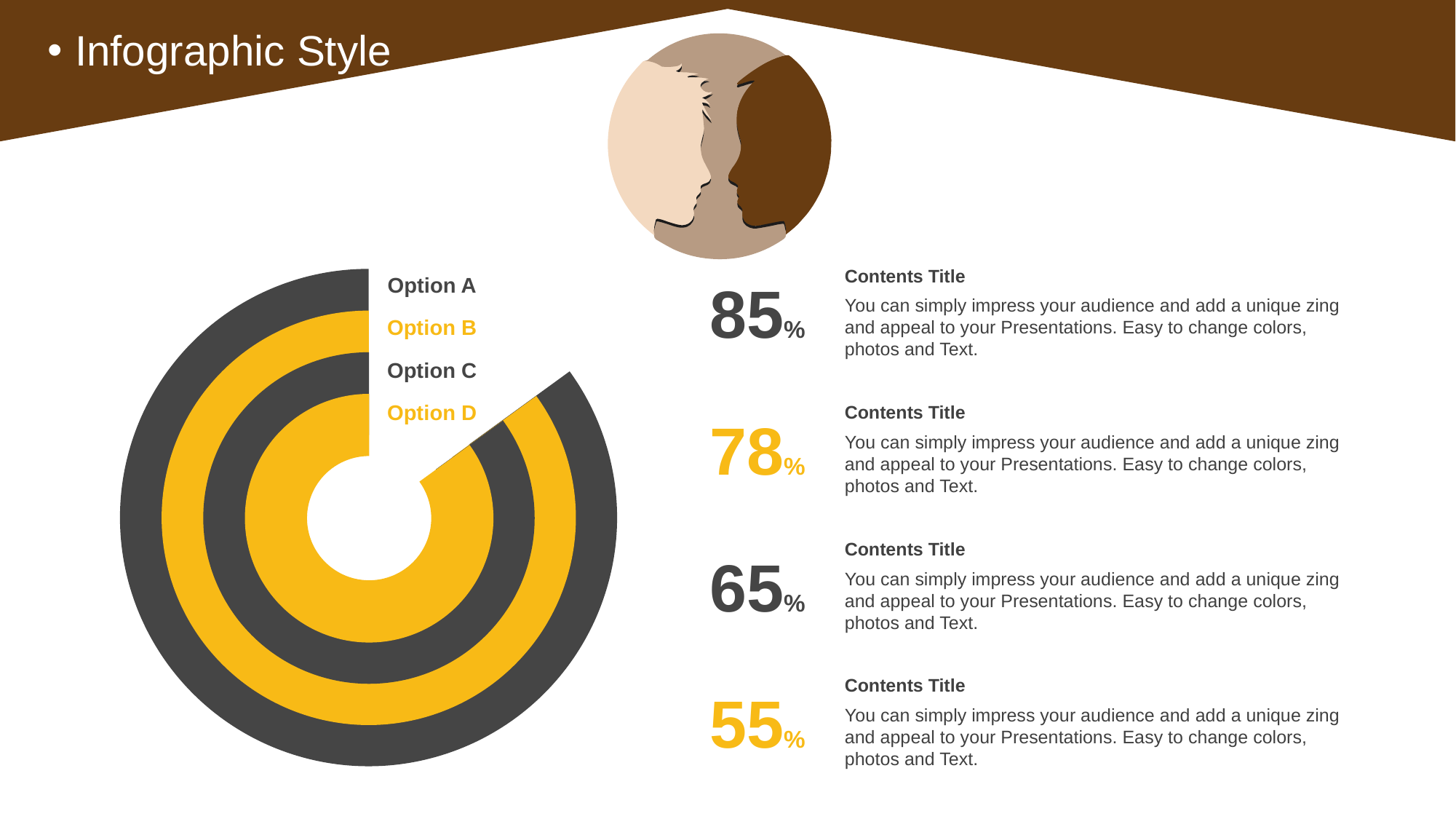
What kind of chart is shown on the left of the slide? doughnut chart What is the difference between the 78% and 65% values listed on the slide? 13% Which option is represented by the outermost ring of the chart? Option A What is the lowest percentage listed on the right side of the slide? 55% What percentage is listed next to the fourth 'Contents Title' block? 55% What colour is the ring for Option B? yellow What is the highest percentage listed on the right side of the slide? 85% How many options are labeled on the ring chart? 4 Which is larger, the second percentage listed (78%) or the third (65%)? 78% What percentage is listed next to the second 'Contents Title' block? 78% How many percentage values are listed on the right side of the slide? 4 What is the difference between the highest and lowest percentages listed on the slide? 30%